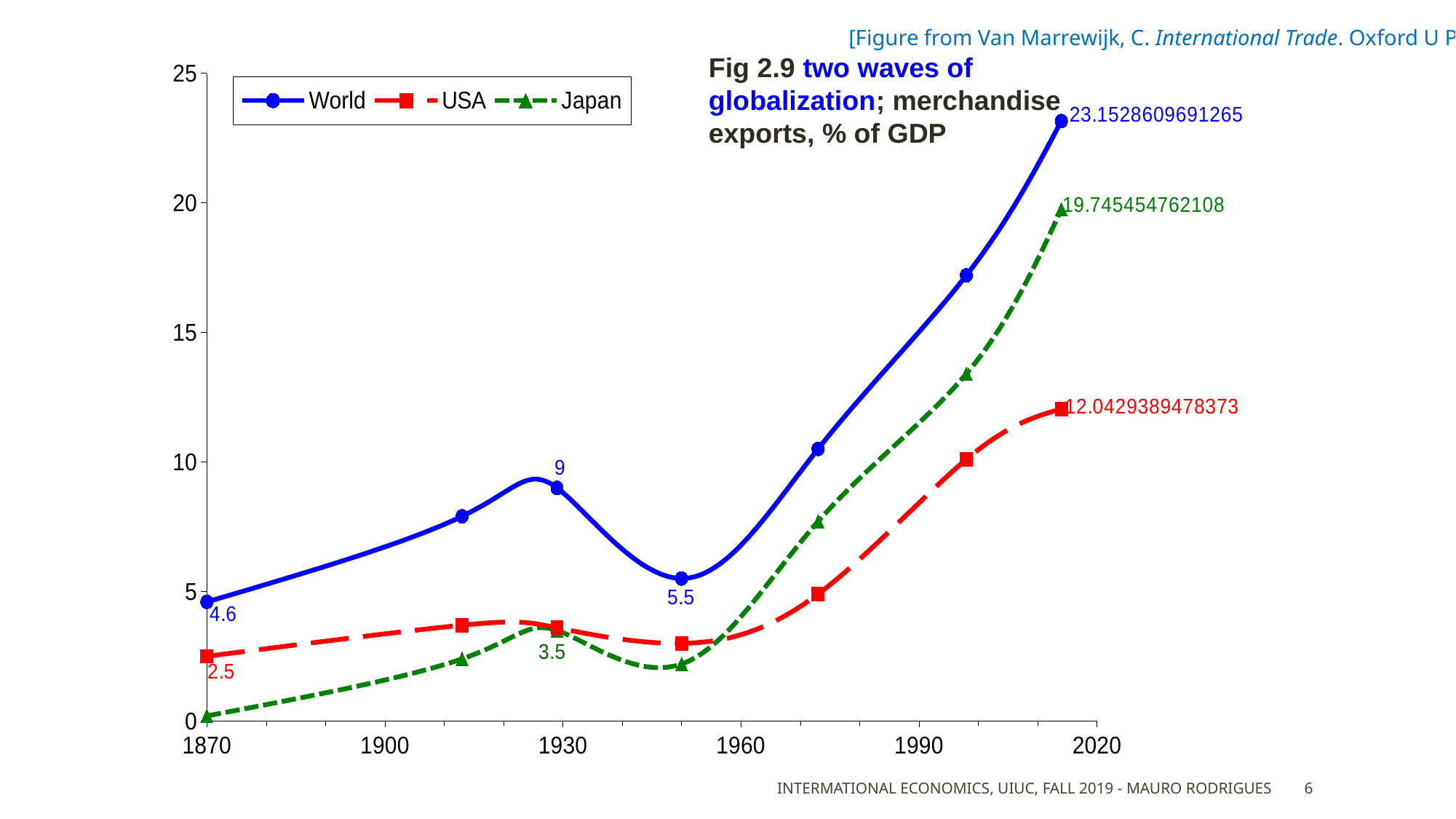
Which is larger in 1870, the World value or the USA value? World What is the value of the last World data point (around 2006)? 23.1528609691265 What is the difference between the World value and the USA value in 1870? 2.1 What is the value for USA in 1870? 2.5 Which series are listed in the legend? World, USA, Japan How many series does the legend list? 3 What is the value for World in 1870? 4.6 What is the value of the last Japan data point (around 2006)? 19.745454762108 Is the value for Japan in 1870 greater or less than 5? less Which series has the highest value at the final data point? World What kind of chart is shown on the slide? line chart What is the value of the last USA data point (around 2006)? 12.0429389478373